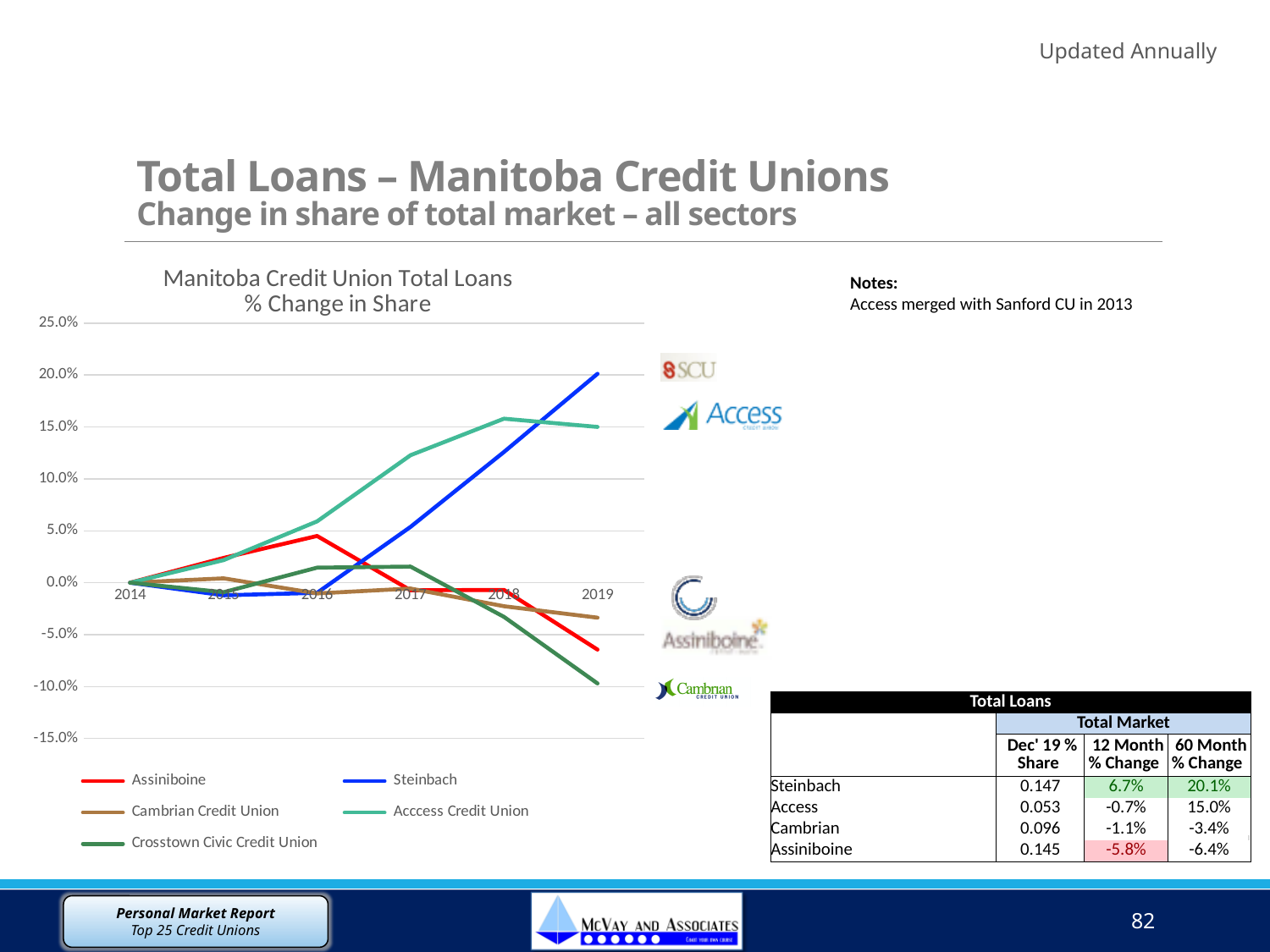
Which credit union has the highest % change in share in 2019? Steinbach How many series does the chart legend list? 5 In 2018, which is larger: the value for Acccess Credit Union or the value for Steinbach? Acccess Credit Union Does the Steinbach line rise or fall from 2016 to 2019? rises Is the value for Acccess Credit Union in 2019 greater or less than 10.0%? greater Is the value for Assiniboine in 2016 greater or less than 0.0%? greater What kind of chart is shown on the slide? line chart What is the title of the chart? Manitoba Credit Union Total Loans % Change in Share Which credit union has the lowest % change in share in 2019? Crosstown Civic Credit Union How many years are shown along the x axis of the chart? 6 Is the value for Crosstown Civic Credit Union in 2019 greater or less than -5.0%? less